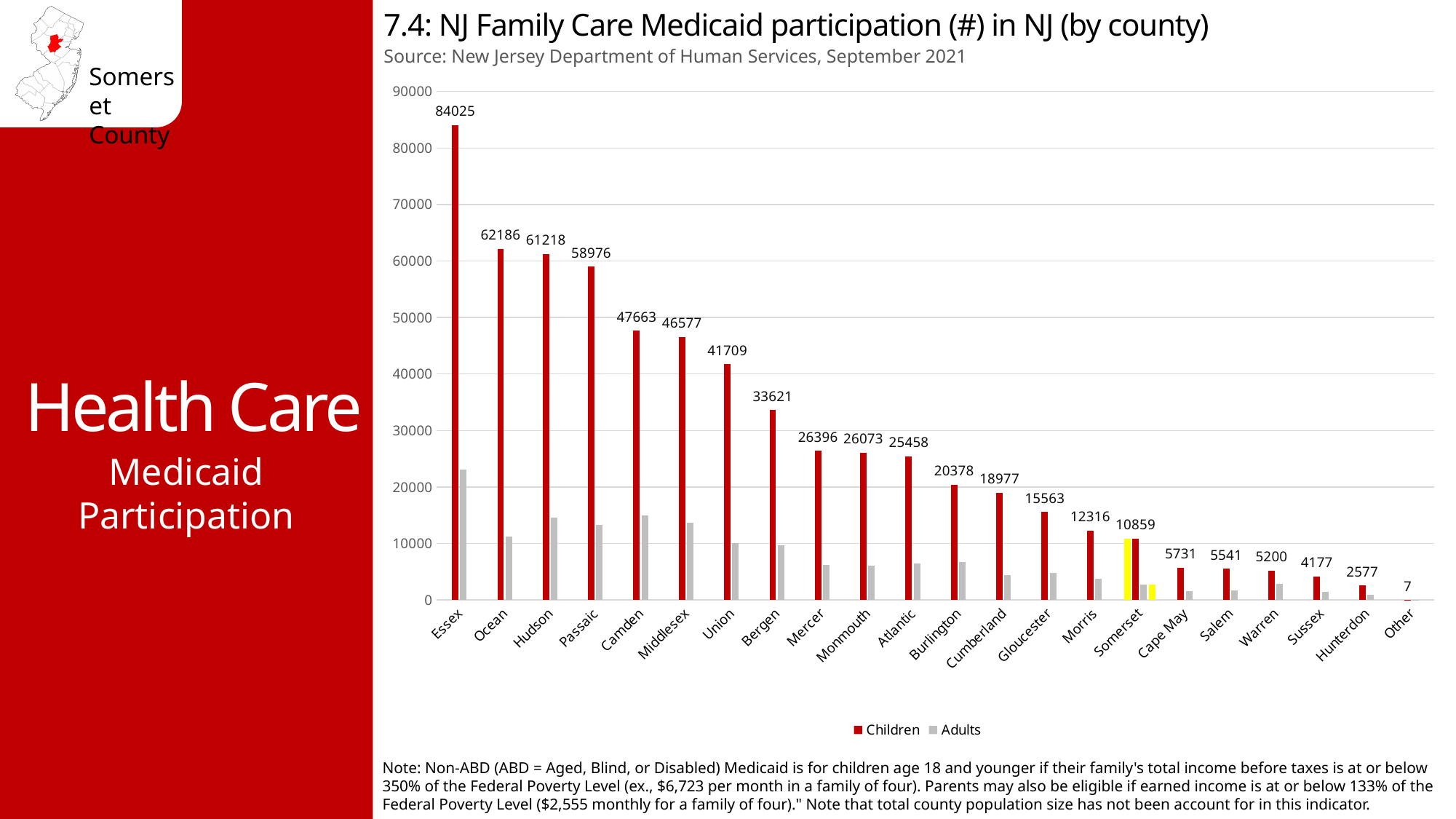
Is the Adults value for Essex greater or less than 20000? greater Which category has the highest Children value? Essex Is the Adults value for Somerset greater or less than 10000? less What is the difference between the Children values for Ocean and Hudson? 968 How many series does the legend list? 2 What is the Children value for Essex? 84025 How many categories are shown on the x axis? 22 What kind of chart is shown on the slide? bar chart Which has a larger Children value, Camden or Middlesex? Camden Do the Children values rise or fall moving from left to right along the x axis? fall Which category has the lowest Children value? Other What is the Children value for Somerset? 10859